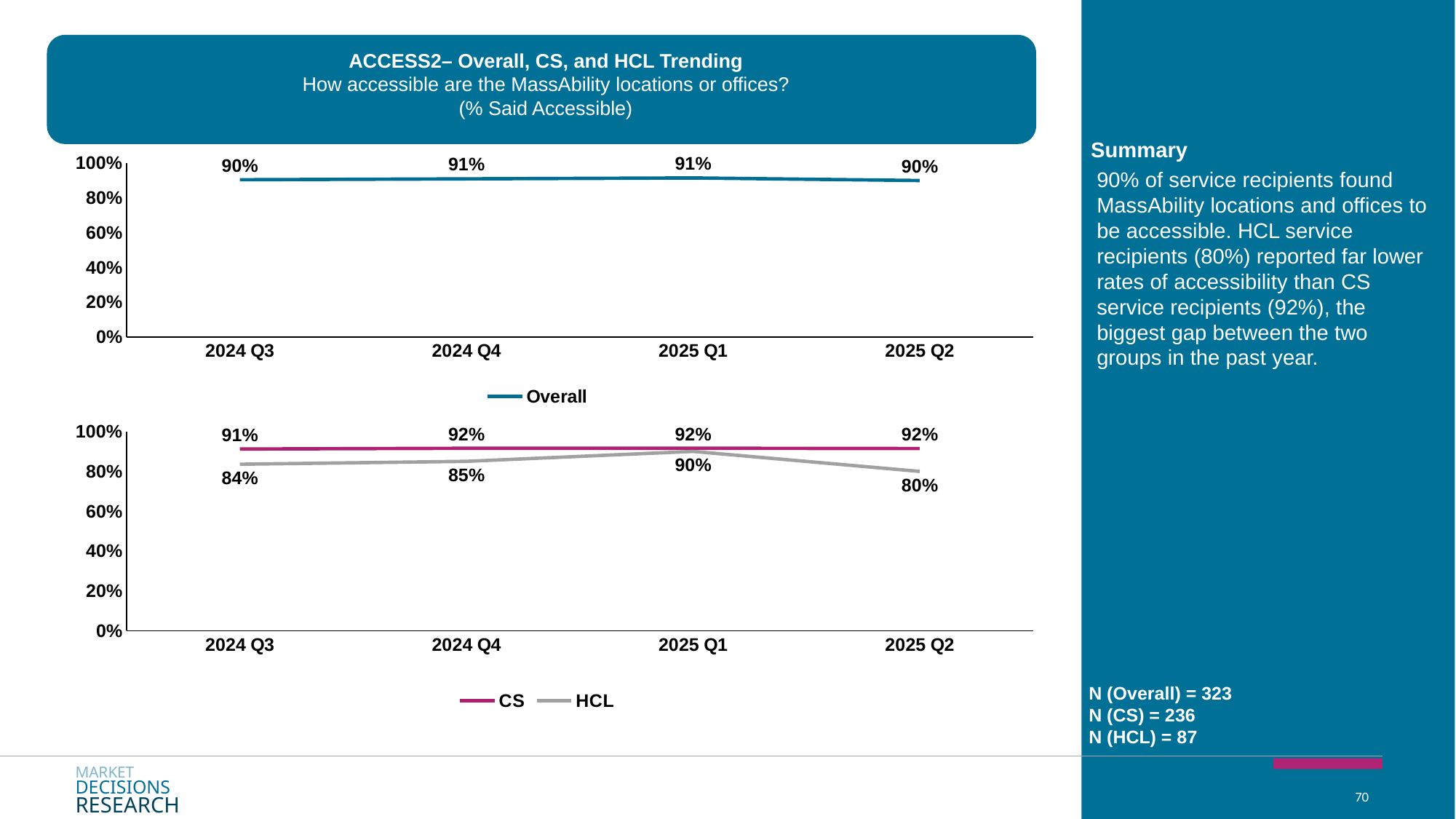
What kind of chart is the top chart? Line chart In the bottom chart, what is the difference between the CS and HCL values in 2025 Q2? 12% In the bottom chart, what is the HCL value for 2025 Q2? 80% In the bottom chart, which quarter has the highest HCL value? 2025 Q1 In the bottom chart, what is the CS value for 2024 Q3? 91% In the bottom chart, which quarter has the lowest HCL value? 2025 Q2 How many series does the legend of the bottom chart list? 2 In the top chart (Overall), what is the value for 2024 Q4? 91% In the bottom chart, what is the HCL value for 2025 Q1? 90% In the top chart (Overall), what is the value for 2025 Q2? 90% How many quarters are plotted on the x axis of the top chart? 4 In the bottom chart, which is larger in 2024 Q4, the CS value or the HCL value? CS